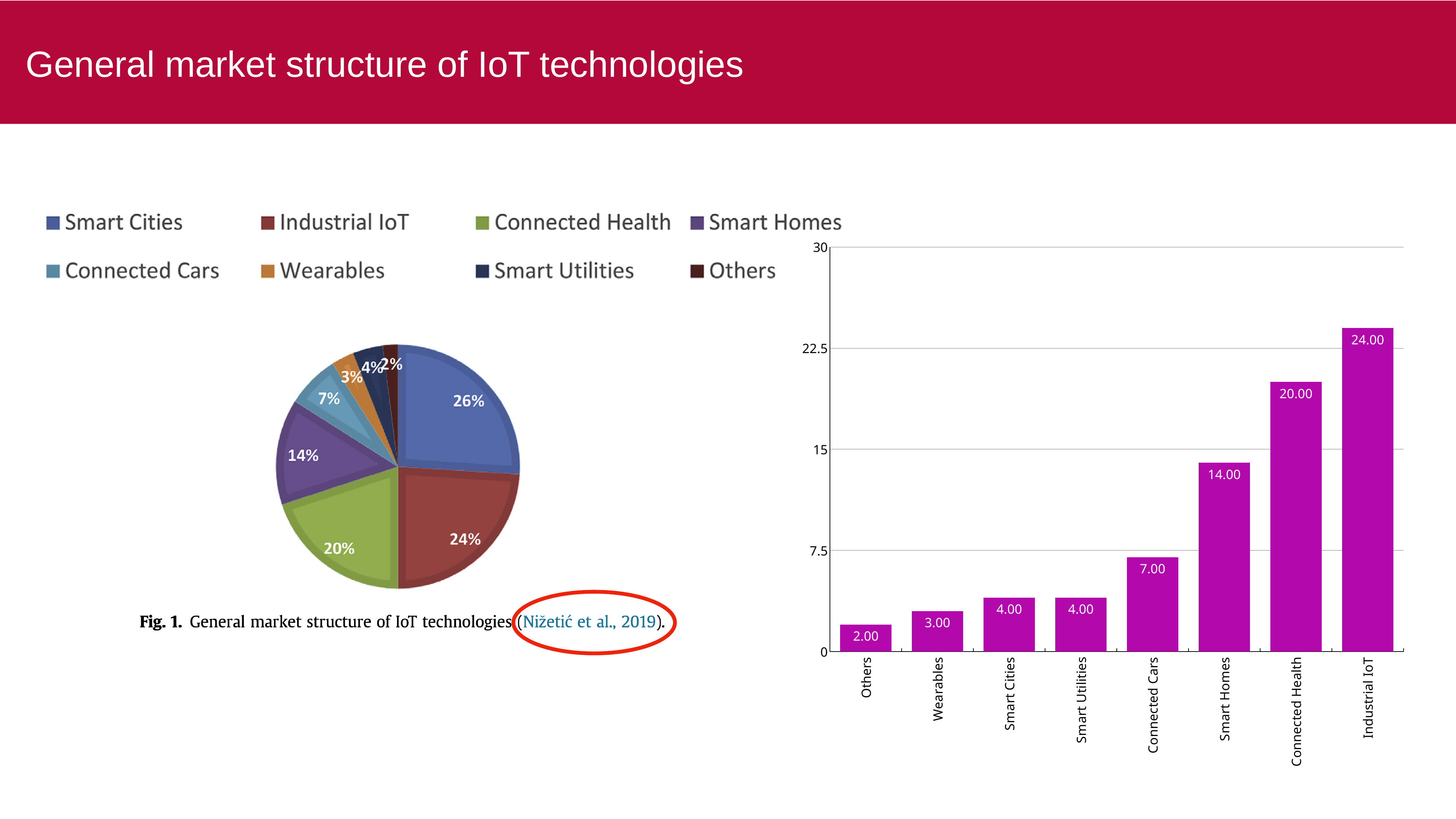
In the pie chart on the left, which category has the smallest slice? Others What kind of chart is shown on the right side of the slide? Bar chart In the bar chart on the right, which category has the highest value? Industrial IoT In the pie chart on the left, how many categories does the legend list? 8 In the bar chart on the right, what is the difference between Industrial IoT and Smart Homes? 10.00 In the bar chart on the right, what is the value for Connected Health? 20.00 In the pie chart on the left, what share does Connected Health have? 20% In the bar chart on the right, what is the value for Connected Cars? 7.00 In the pie chart on the left, what share does Smart Cities have? 26% In the pie chart on the left, which category has the largest slice? Smart Cities In the pie chart on the left, what is the difference between the Industrial IoT share and the Smart Homes share? 10% In the bar chart on the right, which is larger, Smart Homes or Wearables? Smart Homes